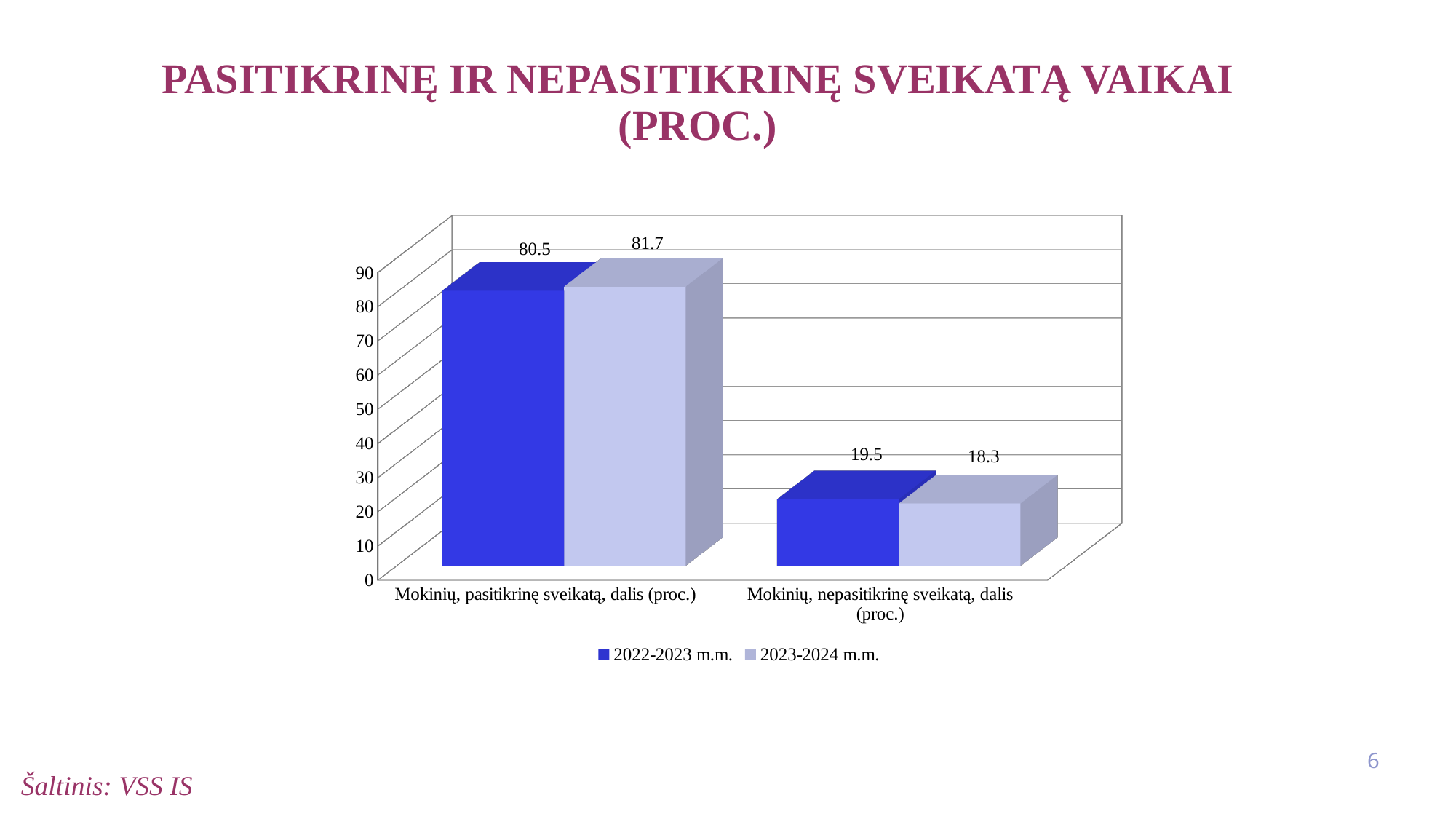
What is the difference between the 2022-2023 m.m. and 2023-2024 m.m. values for 'Mokinių, nepasitikrinę sveikatą, dalis (proc.)'? 1.2 What is the value for 'Mokinių, nepasitikrinę sveikatą, dalis (proc.)' in the 2023-2024 m.m. series? 18.3 How many categories are shown on the x axis? 2 What is the value for 'Mokinių, nepasitikrinę sveikatą, dalis (proc.)' in the 2022-2023 m.m. series? 19.5 What is the difference between the 2023-2024 m.m. and 2022-2023 m.m. values for 'Mokinių, pasitikrinę sveikatą, dalis (proc.)'? 1.2 What is the value for 'Mokinių, pasitikrinę sveikatą, dalis (proc.)' in the 2023-2024 m.m. series? 81.7 Which is larger for 'Mokinių, nepasitikrinę sveikatą, dalis (proc.)': the 2022-2023 m.m. value or the 2023-2024 m.m. value? 2022-2023 m.m. Which category has the lowest value in the 2022-2023 m.m. series? Mokinių, nepasitikrinę sveikatą, dalis (proc.) How many series does the legend list? 2 Which category has the highest value in the 2023-2024 m.m. series? Mokinių, pasitikrinę sveikatą, dalis (proc.) What kind of chart is shown on the slide? Bar chart What is the value for 'Mokinių, pasitikrinę sveikatą, dalis (proc.)' in the 2022-2023 m.m. series? 80.5